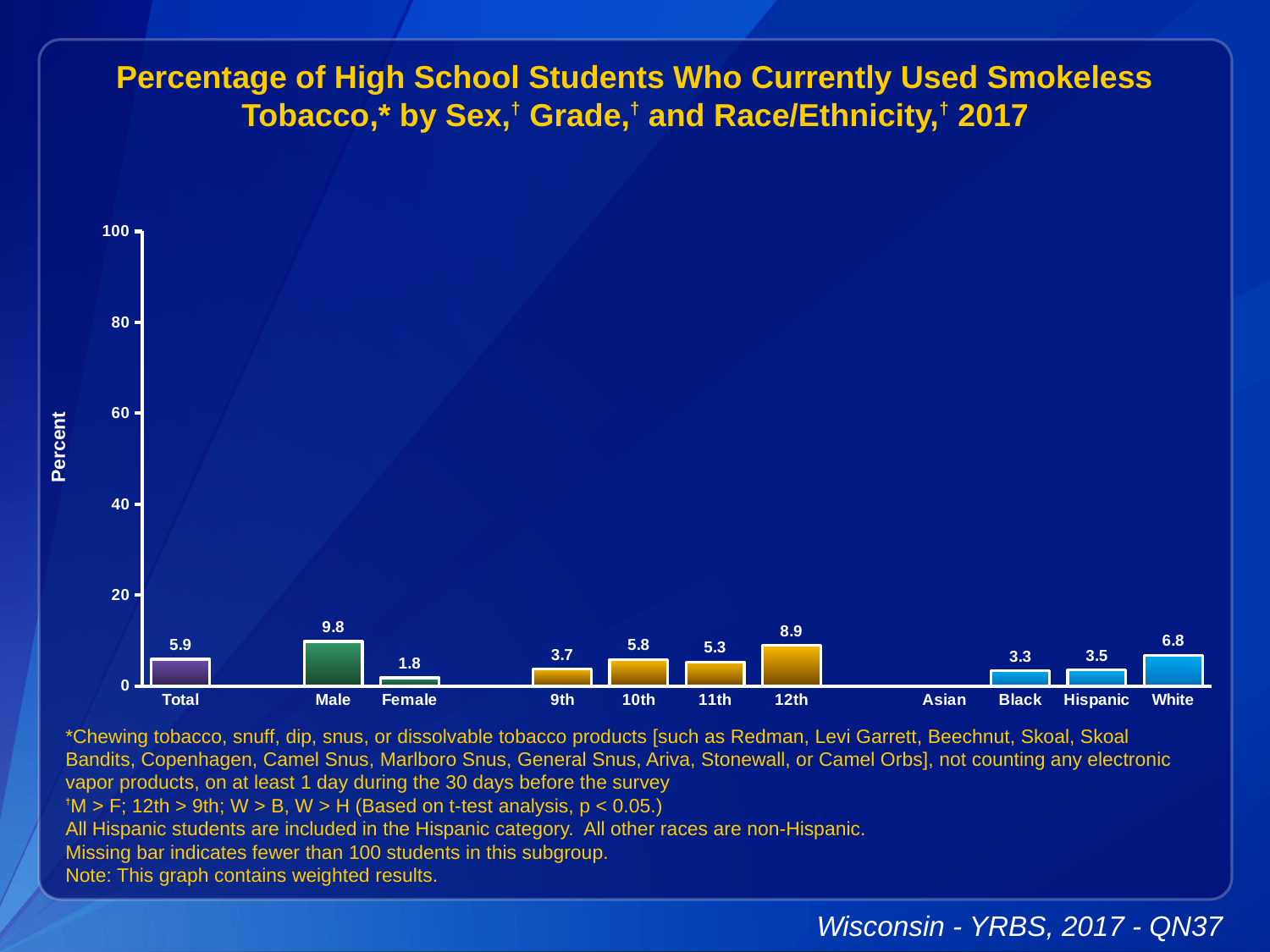
Which category has no bar shown? Asian How many categories have a bar shown? 10 Which is larger, the value for 10th grade or 11th grade? 10th Is the value for Male greater or less than 20? less What is the value for 12th grade? 8.9 Which category has the highest value? Male What is the difference between the Male and Female values? 8.0 What is the value for Total? 5.9 Which category with a bar has the lowest value? Female What is the value for Female? 1.8 What is the value for Male? 9.8 What kind of chart is this? bar chart